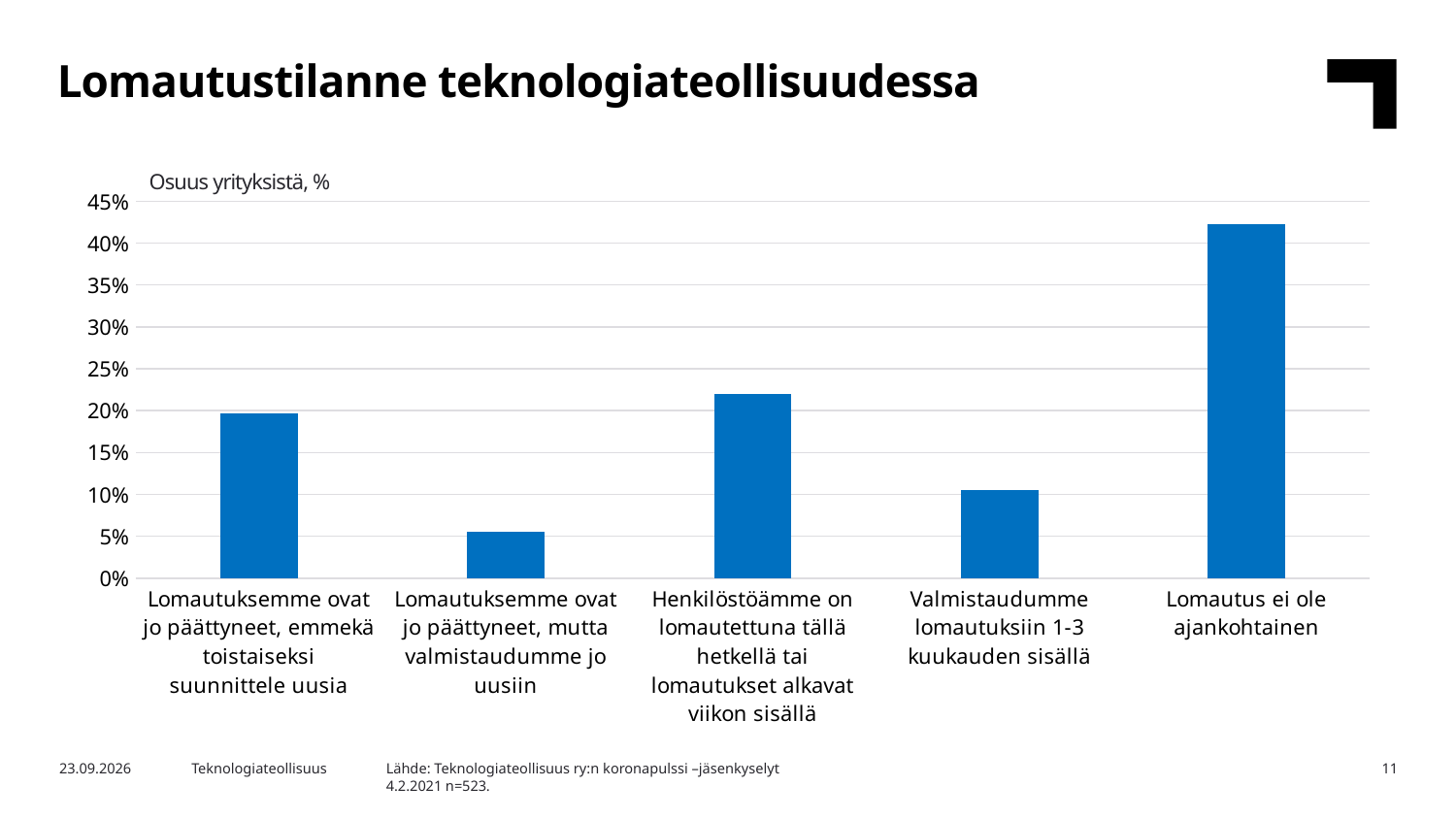
Is the value for 'Henkilöstöämme on lomautettuna tällä hetkellä tai lomautukset alkavat viikon sisällä' greater or less than 20%? greater What label is shown above the y axis of the chart? Osuus yrityksistä, % Is the value for 'Lomautuksemme ovat jo päättyneet, emmekä toistaiseksi suunnittele uusia' greater or less than 15%? greater Is the value for 'Lomautus ei ole ajankohtainen' greater or less than 40%? greater What kind of chart is shown on the slide? bar chart What is the title of the slide containing the chart? Lomautustilanne teknologiateollisuudessa How many categories are shown on the x axis of the chart? 5 Which category has the lowest value? Lomautuksemme ovat jo päättyneet, mutta valmistaudumme jo uusiin Which category has the highest value? Lomautus ei ole ajankohtainen Which is larger: the value for 'Valmistaudumme lomautuksiin 1-3 kuukauden sisällä' or the value for 'Lomautuksemme ovat jo päättyneet, emmekä toistaiseksi suunnittele uusia'? Lomautuksemme ovat jo päättyneet, emmekä toistaiseksi suunnittele uusia